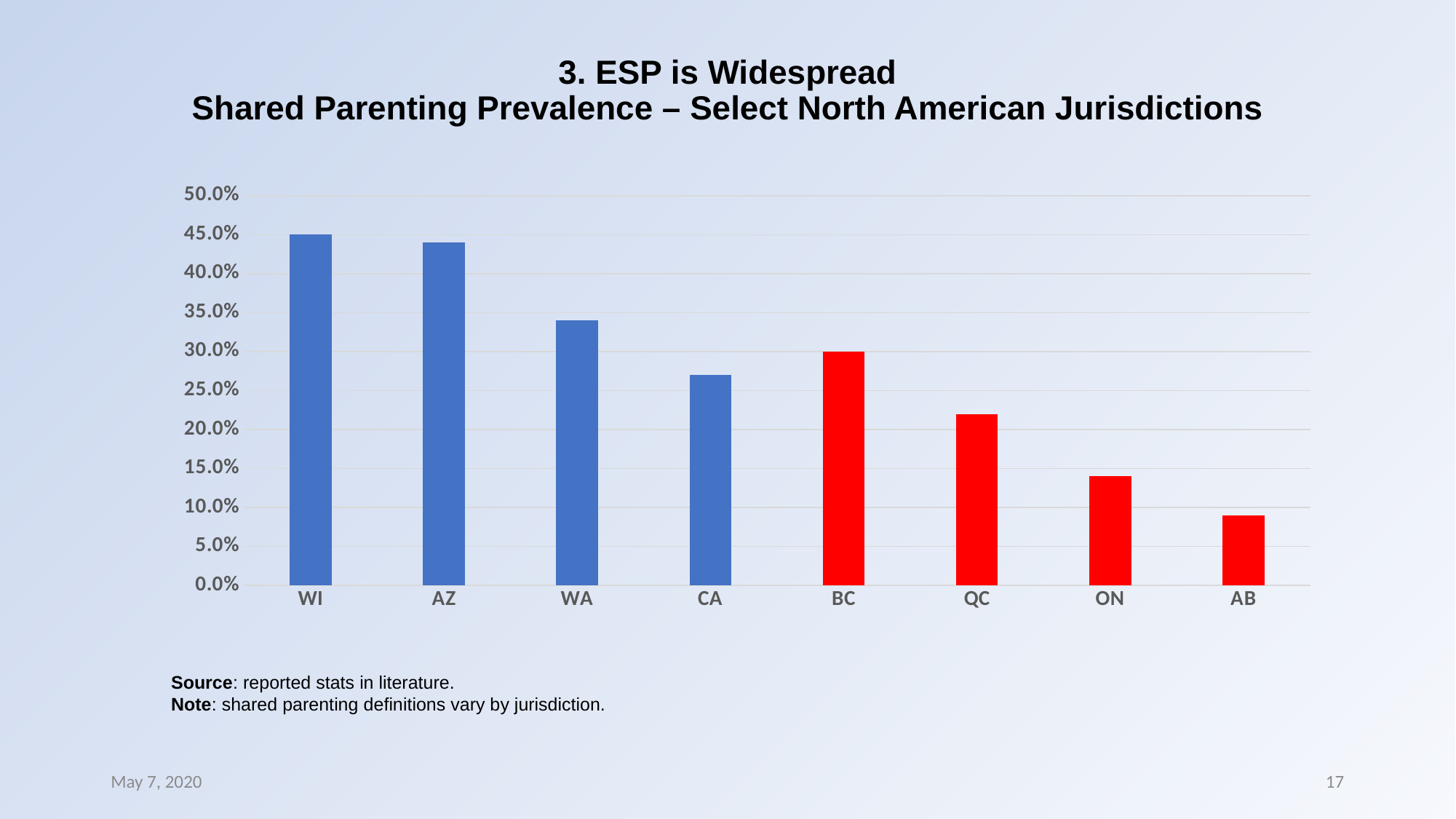
What type of chart is shown on the slide? Bar chart Is the value for ON greater or less than 15.0%? less Which jurisdiction has the lowest shared parenting prevalence? AB What is the shared parenting prevalence for BC? 30.0% Which jurisdiction has the highest shared parenting prevalence? WI Which has a higher shared parenting prevalence, CA or BC? BC Which has a higher shared parenting prevalence, WA or BC? WA What is the shared parenting prevalence for WI? 45.0% How many jurisdictions are plotted on the chart? 8 Is the value for AZ greater or less than 40.0%? greater Is the value for AB greater or less than 10.0%? less Which jurisdictions are shown with red bars? BC, QC, ON, AB